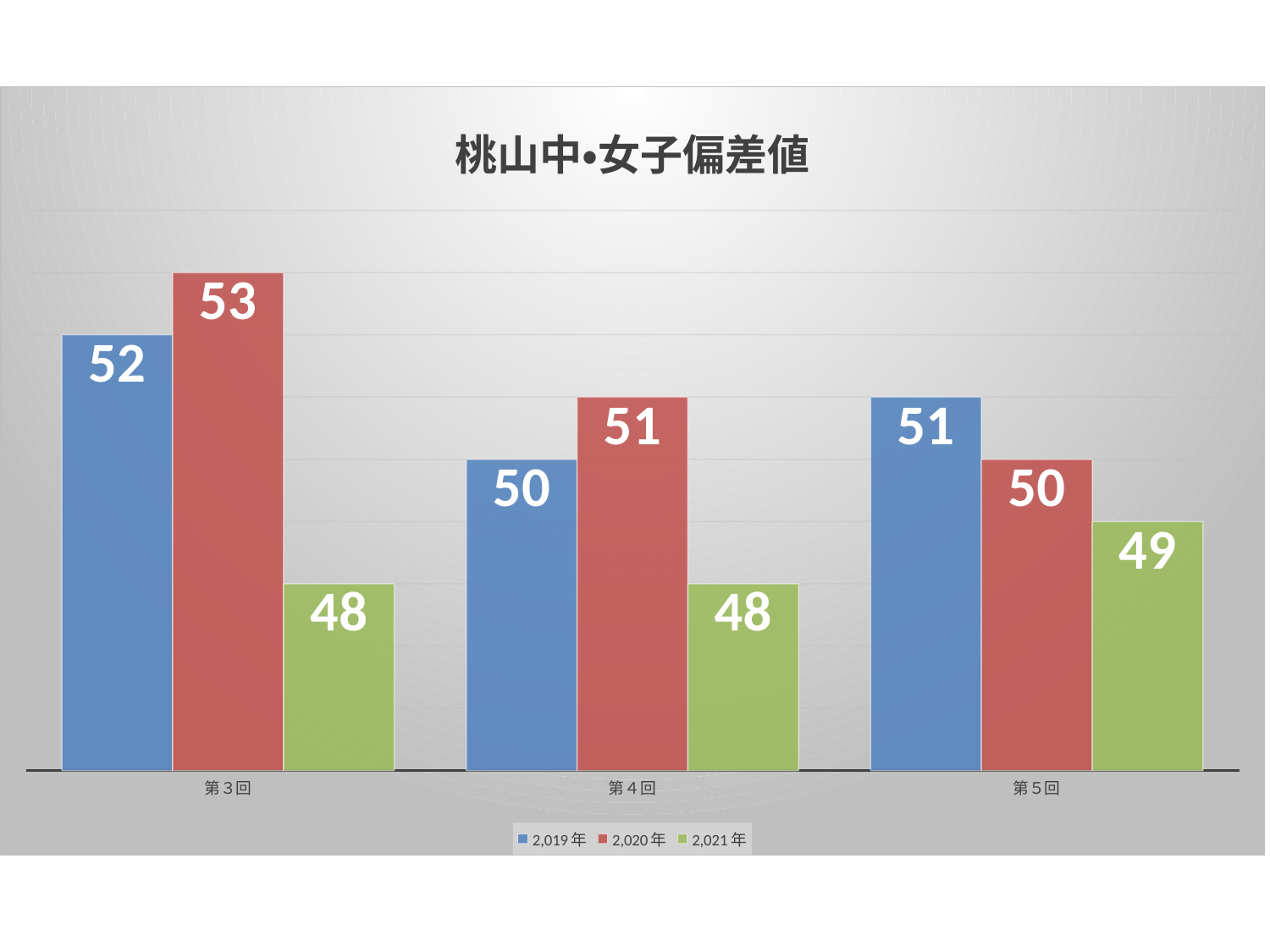
What kind of chart is shown on the slide? bar chart What is the value for 2,021年 in 第5回? 49 Which category has the lowest value for the 2,019年 series? 第4回 Does the 2,020年 series rise or fall from 第3回 to 第5回? fall Which is larger in 第5回: the 2,019年 value or the 2,020年 value? 2,019年 What is the value for 2,019年 in 第3回? 52 What is the difference between the 2,020年 and 2,021年 values in 第3回? 5 What is the value for 2,020年 in 第4回? 51 How many series does the legend list? 3 How many categories are shown on the x axis? 3 Which category has the highest value for the 2,020年 series? 第3回 What is the title of the chart? 桃山中•女子偏差値